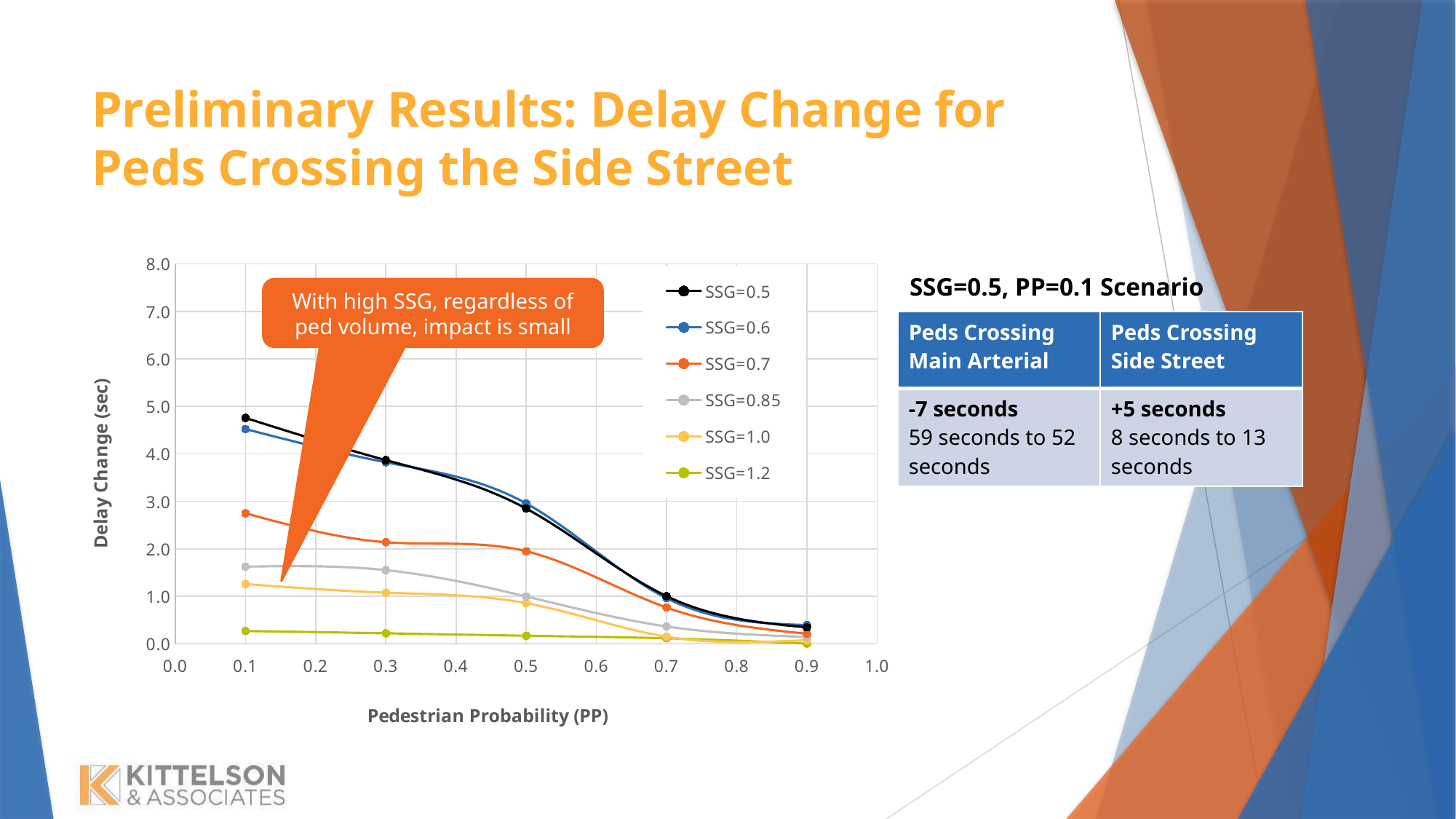
Which series has the lowest Delay Change at PP=0.1? SSG=1.2 Is the Delay Change for SSG=0.5 at PP=0.1 greater or less than 4.0? greater How many data points are plotted for the SSG=0.5 series? 5 Is the Delay Change for SSG=0.5 at PP=0.9 greater or less than 1.0? less Do the values for the SSG=0.5 series rise or fall as Pedestrian Probability increases? fall What kind of chart is shown on the slide? line chart Is the Delay Change for SSG=0.7 at PP=0.1 greater or less than 3.0? less How many series does the chart legend list? 6 What is the label of the chart's vertical axis? Delay Change (sec) What is the label of the chart's horizontal axis? Pedestrian Probability (PP) At PP=0.5, which series has the larger Delay Change, SSG=0.7 or SSG=1.0? SSG=0.7